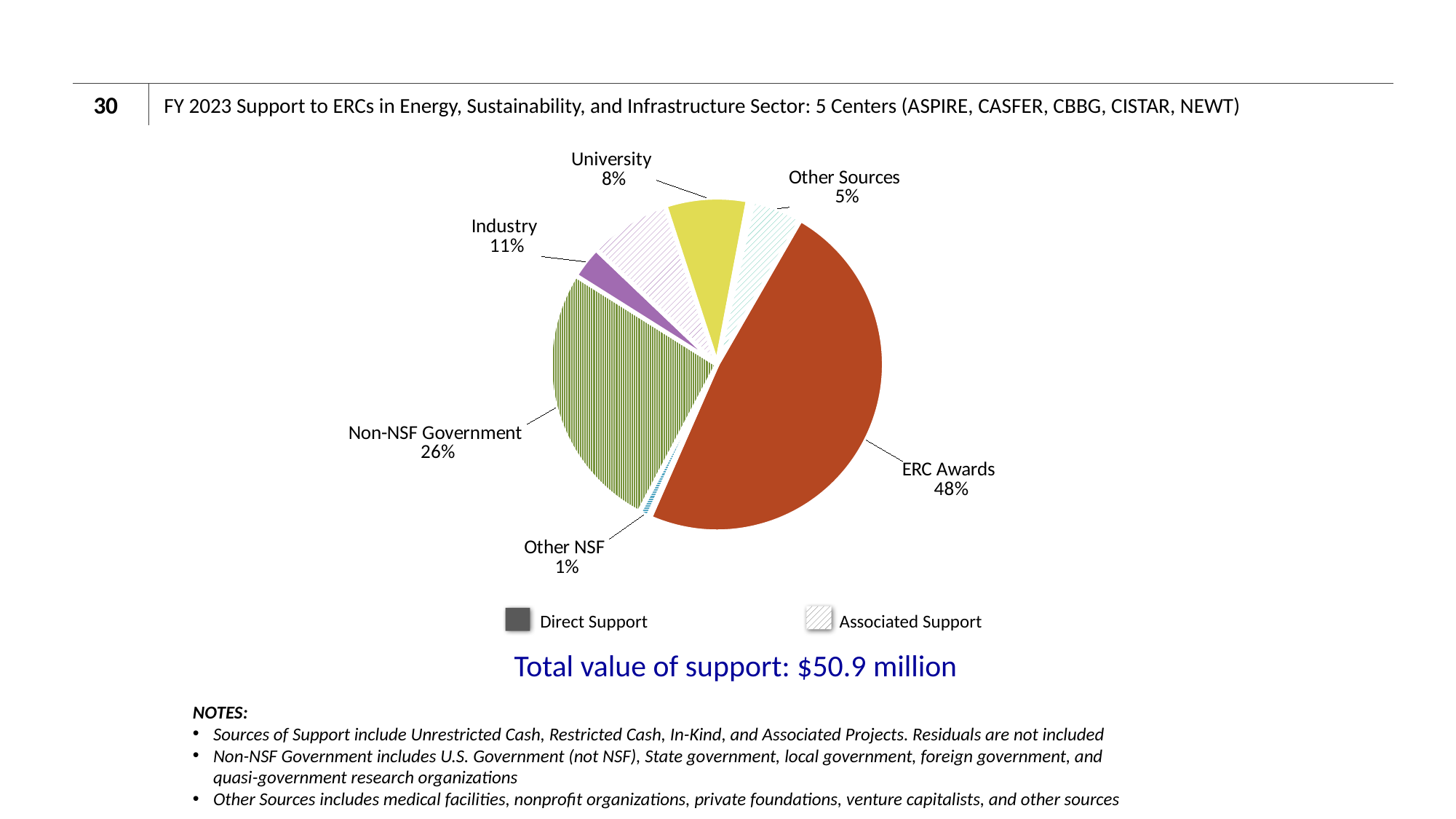
What share of support comes from Non-NSF Government? 26% What share of support comes from Other NSF? 1% What is the total value of support stated below the chart? $50.9 million Which source of support has the smallest share of the pie? Other NSF What is the difference in percentage points between ERC Awards and Non-NSF Government? 22 What share of support comes from Industry? 11% What share of support comes from University? 8% What type of chart is shown on the slide? pie chart What share of support comes from ERC Awards? 48% Which source of support has the largest share of the pie? ERC Awards Which has a larger share, Industry or Other Sources? Industry